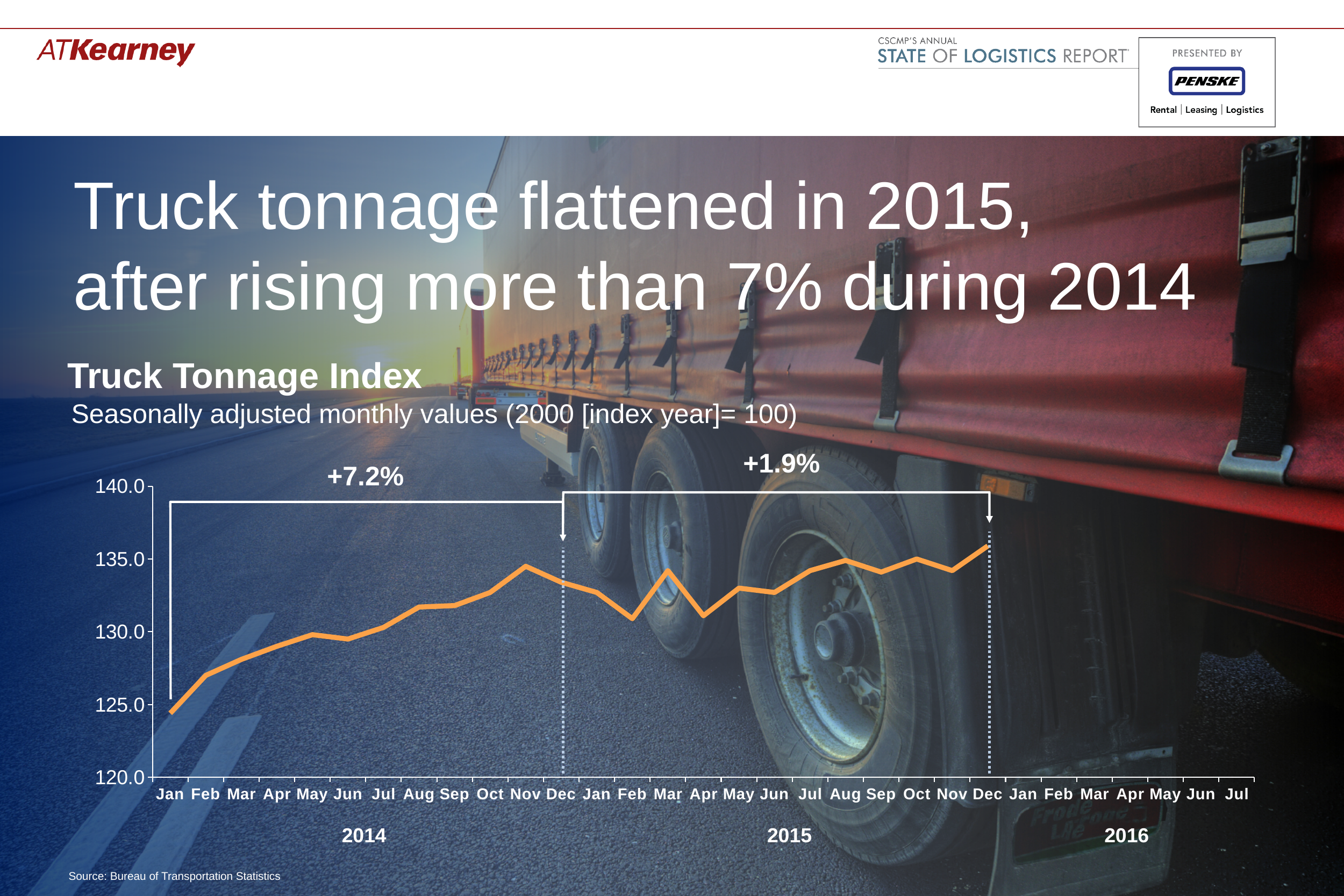
Is the value for Dec 2015 greater or less than 135.0? greater What kind of chart is shown on the slide? line chart Which is larger, the value for Mar 2015 or the value for Apr 2015? Mar 2015 What percentage change is annotated above the 2014 portion of the line? +7.2% Is the value for Jan 2014 greater or less than 125.0? less What is the title of the chart? Truck Tonnage Index Which month has the highest plotted value on the chart? Dec 2015 Does the line generally rise or fall across 2014? rise How many years are labeled along the x axis? 3 Is the value for Mar 2014 greater or less than 130.0? less Which month has the lowest plotted value on the chart? Jan 2014